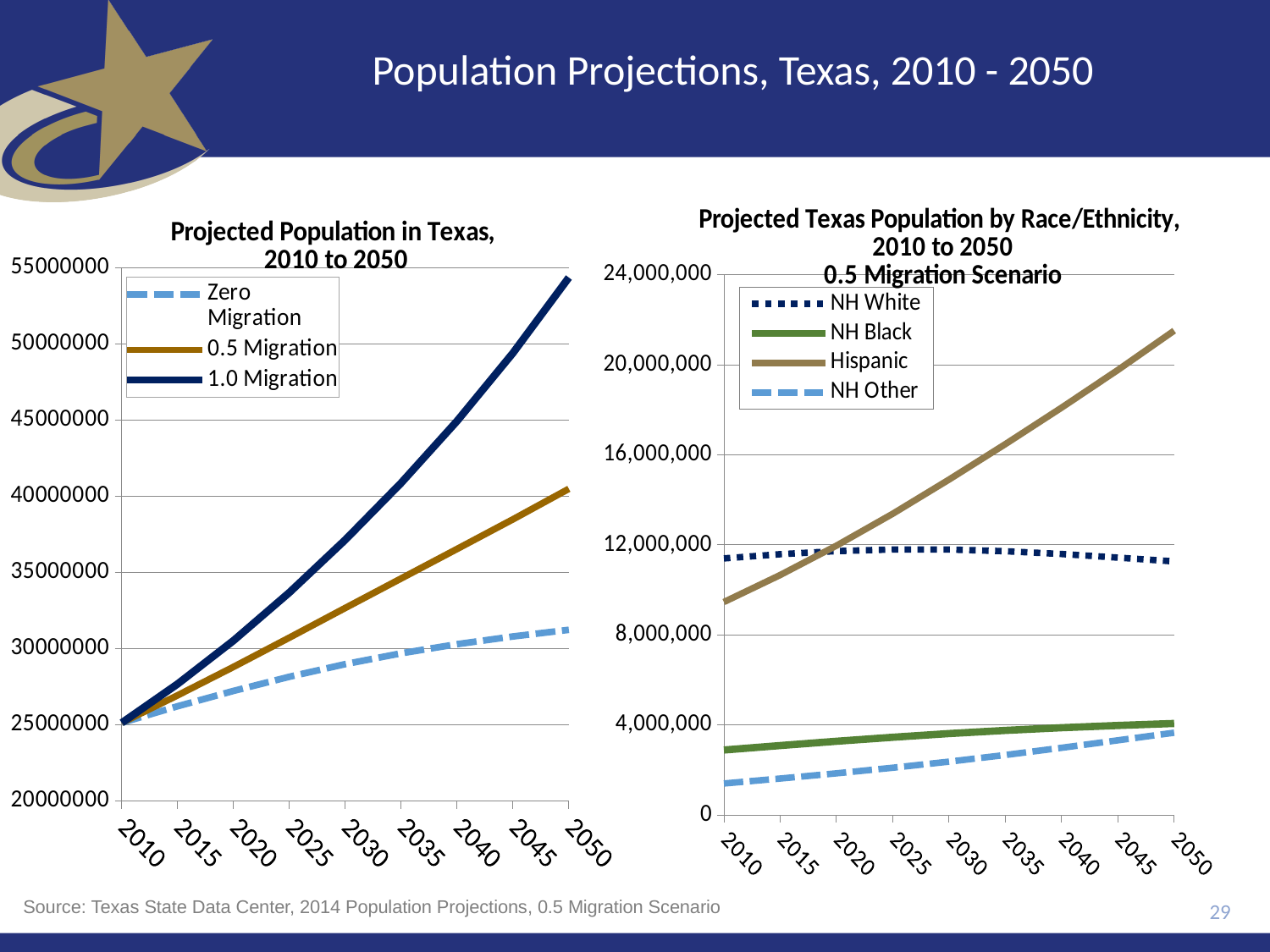
In the right chart, 'Projected Texas Population by Race/Ethnicity', is the value for Hispanic in 2050 greater or less than 20,000,000? greater How many series does the legend of the right chart, 'Projected Texas Population by Race/Ethnicity', list? 4 What kind of chart is the 'Projected Population in Texas, 2010 to 2050' chart on the left? line chart Which migration scenario does the right chart, 'Projected Texas Population by Race/Ethnicity', use according to its title? 0.5 Migration Scenario In the right chart, 'Projected Texas Population by Race/Ethnicity', does the Hispanic series rise or fall from 2010 to 2050? rise In the left chart, 'Projected Population in Texas', which migration scenario has the highest value in 2050? 1.0 Migration In the right chart, 'Projected Texas Population by Race/Ethnicity', is the value for NH White in 2050 greater or less than 12,000,000? less In the left chart, 'Projected Population in Texas', which migration scenario has the lowest value in 2050? Zero Migration In the left chart, 'Projected Population in Texas', is the value for 1.0 Migration in 2050 greater or less than 50000000? greater How many series does the legend of the left chart, 'Projected Population in Texas, 2010 to 2050', list? 3 In the right chart, 'Projected Texas Population by Race/Ethnicity', which is larger in 2010: NH White or Hispanic? NH White How many year labels are shown on the x axis of the left chart, 'Projected Population in Texas, 2010 to 2050'? 9